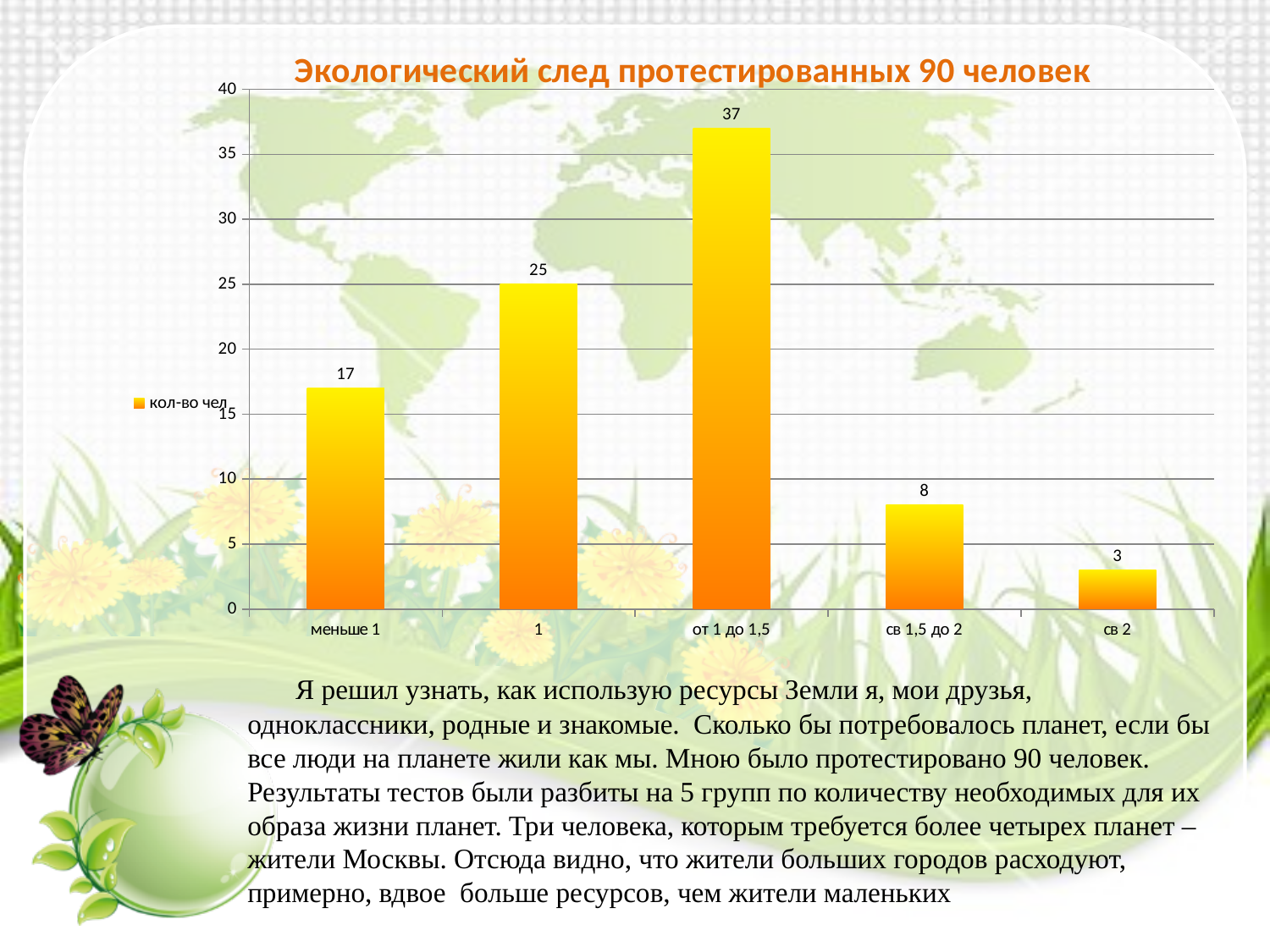
What is the value for the category "от 1 до 1,5"? 37 What is the difference between the values for "от 1 до 1,5" and "1"? 12 What is the value for the category "меньше 1"? 17 What is the value for the category "св 2"? 3 Which is larger, the value for "меньше 1" or the value for "св 1,5 до 2"? меньше 1 What kind of chart is shown on the slide? bar chart Which category has the highest value? от 1 до 1,5 What is the title of the chart? Экологический след протестированных 90 человек How many categories are shown on the x axis? 5 How many series does the legend list? 1 Is the value for "1" greater or less than 20? greater Which category has the lowest value? св 2